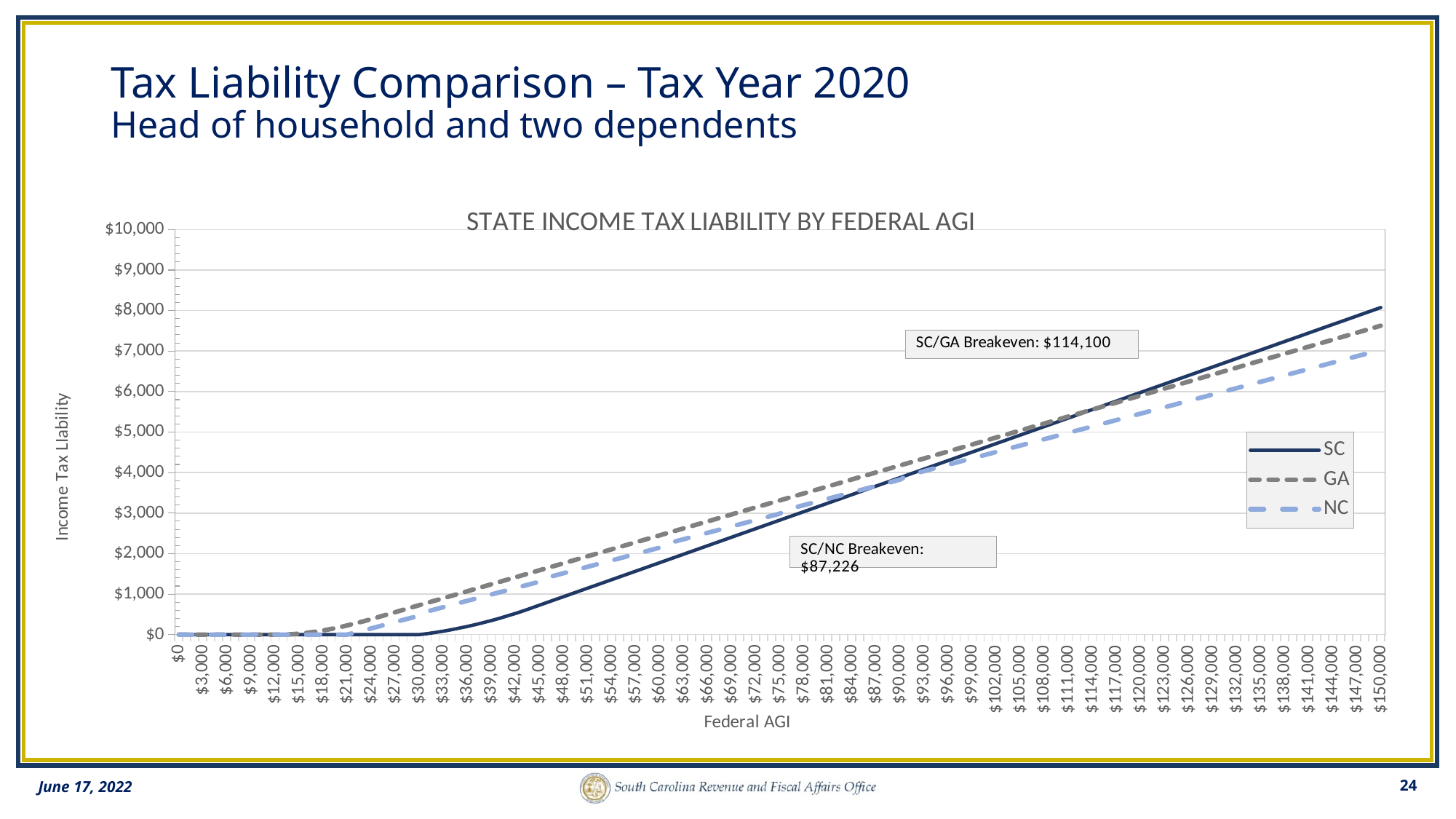
At a federal AGI of $60,000, which is larger, the GA liability or the SC liability? GA How many series does the legend list? 3 Do the income tax liability lines rise or fall as federal AGI increases along the x axis? rise Which series has the highest income tax liability at a federal AGI of $150,000? SC Is the SC income tax liability at a federal AGI of $150,000 greater or less than $7,000? greater What kind of chart is shown on the slide? line chart What is the SC income tax liability at a federal AGI of $30,000? $0 Which series has the lowest income tax liability at a federal AGI of $150,000? NC What is the title of the chart? STATE INCOME TAX LIABILITY BY FEDERAL AGI Is the NC income tax liability at a federal AGI of $150,000 greater or less than $6,000? greater At what federal AGI does the chart annotation say SC and GA break even? $114,100 Is the GA income tax liability at a federal AGI of $150,000 greater or less than $8,000? less